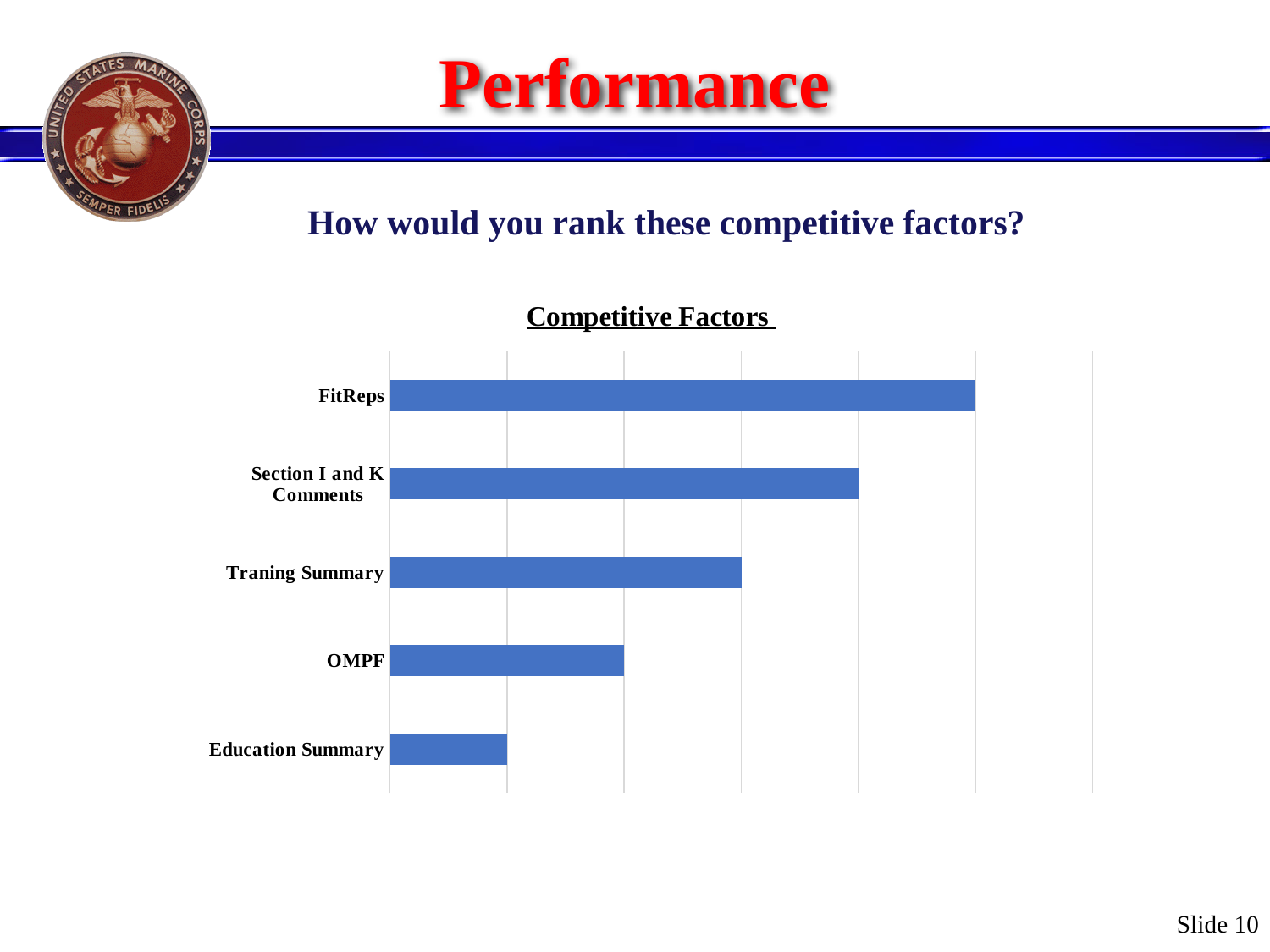
Do the bar lengths increase or decrease going from the top category to the bottom category? decrease Which has the smaller value, Education Summary or OMPF? Education Summary Which category has the longest bar in the Competitive Factors chart? FitReps Which category is ranked second highest in the Competitive Factors chart? Section I and K Comments What is the title of the chart? Competitive Factors Which category has the shortest bar in the Competitive Factors chart? Education Summary How many categories are plotted in the Competitive Factors chart? 5 Which has the larger value, OMPF or Traning Summary? Traning Summary Which category appears at the bottom of the Competitive Factors chart? Education Summary What kind of chart is shown on the slide? bar chart Which has the larger value, Section I and K Comments or FitReps? FitReps